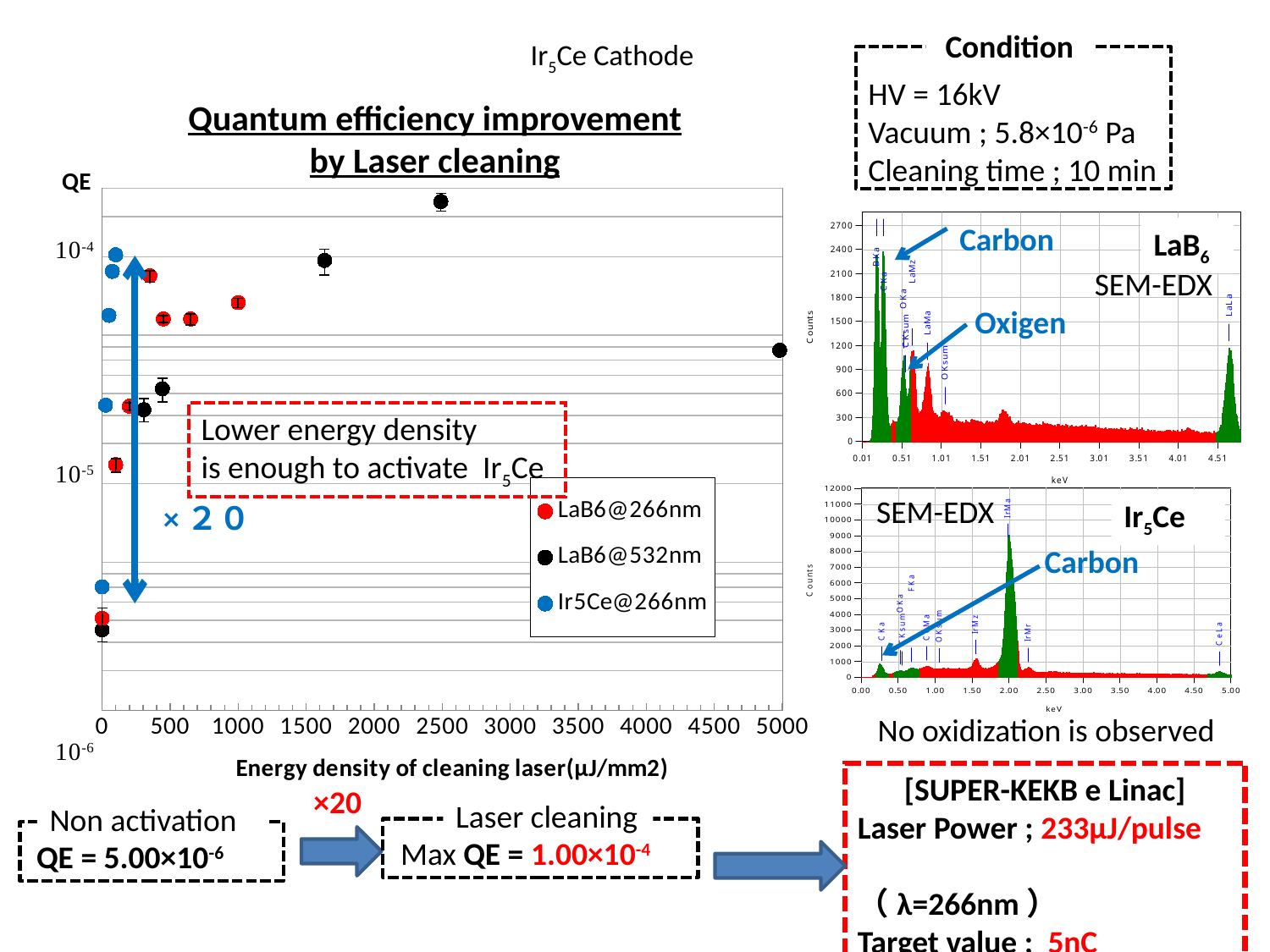
How many series does the legend of the 'Quantum efficiency improvement by Laser cleaning' chart list? 3 What kind of chart is the 'Quantum efficiency improvement by Laser cleaning' chart? Scatter chart In the 'Quantum efficiency improvement by Laser cleaning' chart, does the LaB6@532nm QE rise or fall between energy densities of about 300 and 2500? rise In the 'Quantum efficiency improvement by Laser cleaning' chart, is the LaB6@532nm value at an energy density of about 2500 greater or less than 10^-4? greater What is the x-axis label of the 'Quantum efficiency improvement by Laser cleaning' chart? Energy density of cleaning laser(μJ/mm2) In the 'Quantum efficiency improvement by Laser cleaning' chart, is the LaB6@532nm value at an energy density of 5000 greater or less than 10^-4? less In the Ir5Ce SEM-EDX chart, is the IrMa peak near 2.00 keV greater or less than 8000 counts? greater In the LaB6 SEM-EDX chart, what is the highest value shown on the Counts axis? 2700 In the 'Quantum efficiency improvement by Laser cleaning' chart, which series has a data point at the largest energy density (5000)? LaB6@532nm In the 'Quantum efficiency improvement by Laser cleaning' chart, which series is plotted with blue markers? Ir5Ce@266nm In the 'Quantum efficiency improvement by Laser cleaning' chart, which series contains the highest plotted QE value? LaB6@532nm